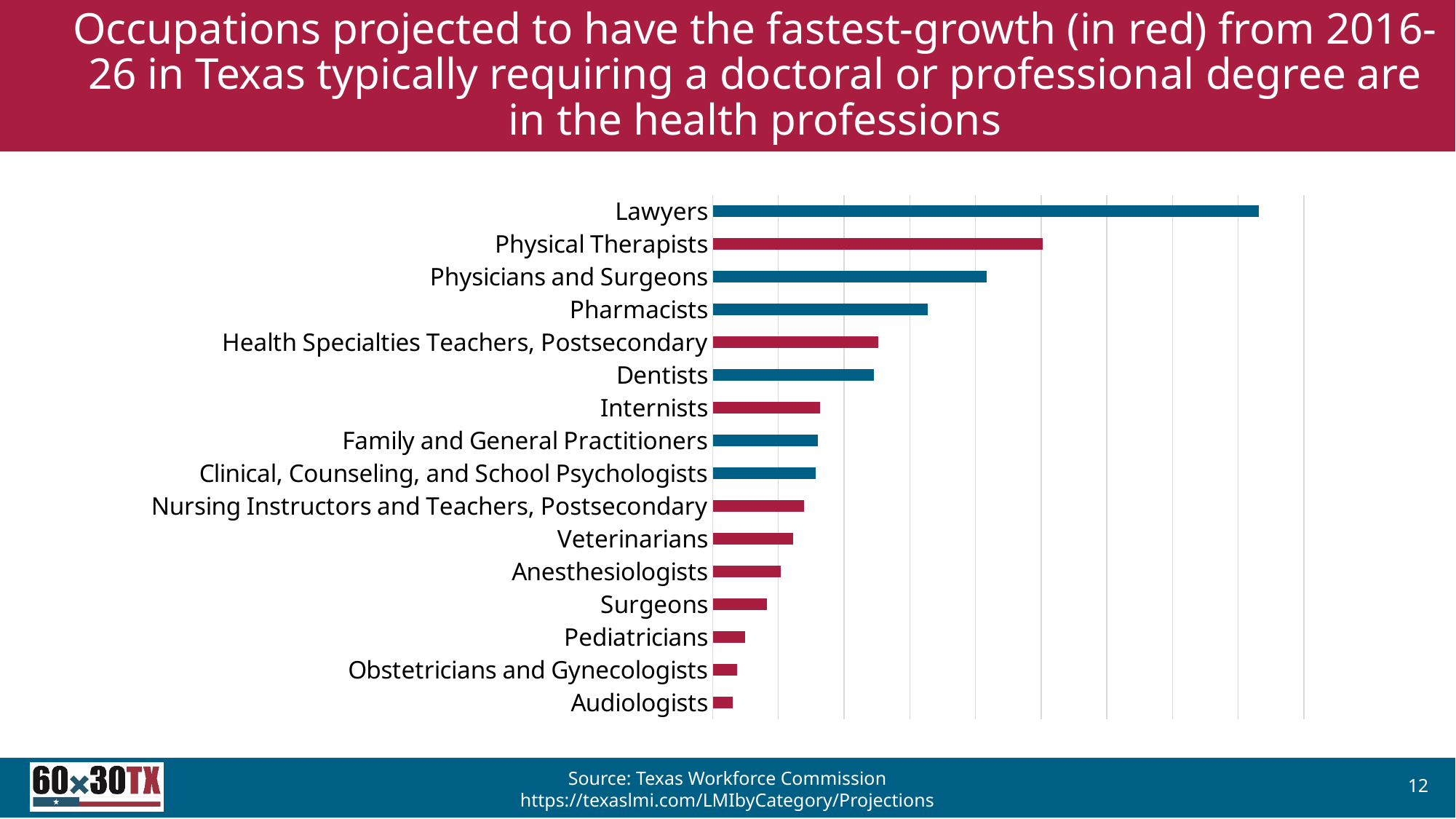
Which has the longer bar, Physicians and Surgeons or Pharmacists? Physicians and Surgeons Which has the longer bar, Surgeons or Pediatricians? Surgeons How many occupations are listed on the chart? 16 Do the bar lengths increase or decrease going from the top of the chart to the bottom? Decrease Which has the longer bar, Lawyers or Physical Therapists? Lawyers Which occupation with a red bar has the longest bar? Physical Therapists How many occupations are shown with red bars? 10 Which occupation has the shortest bar on the chart? Audiologists Which occupation has the longest bar on the chart? Lawyers What kind of chart is shown on the slide? Bar chart